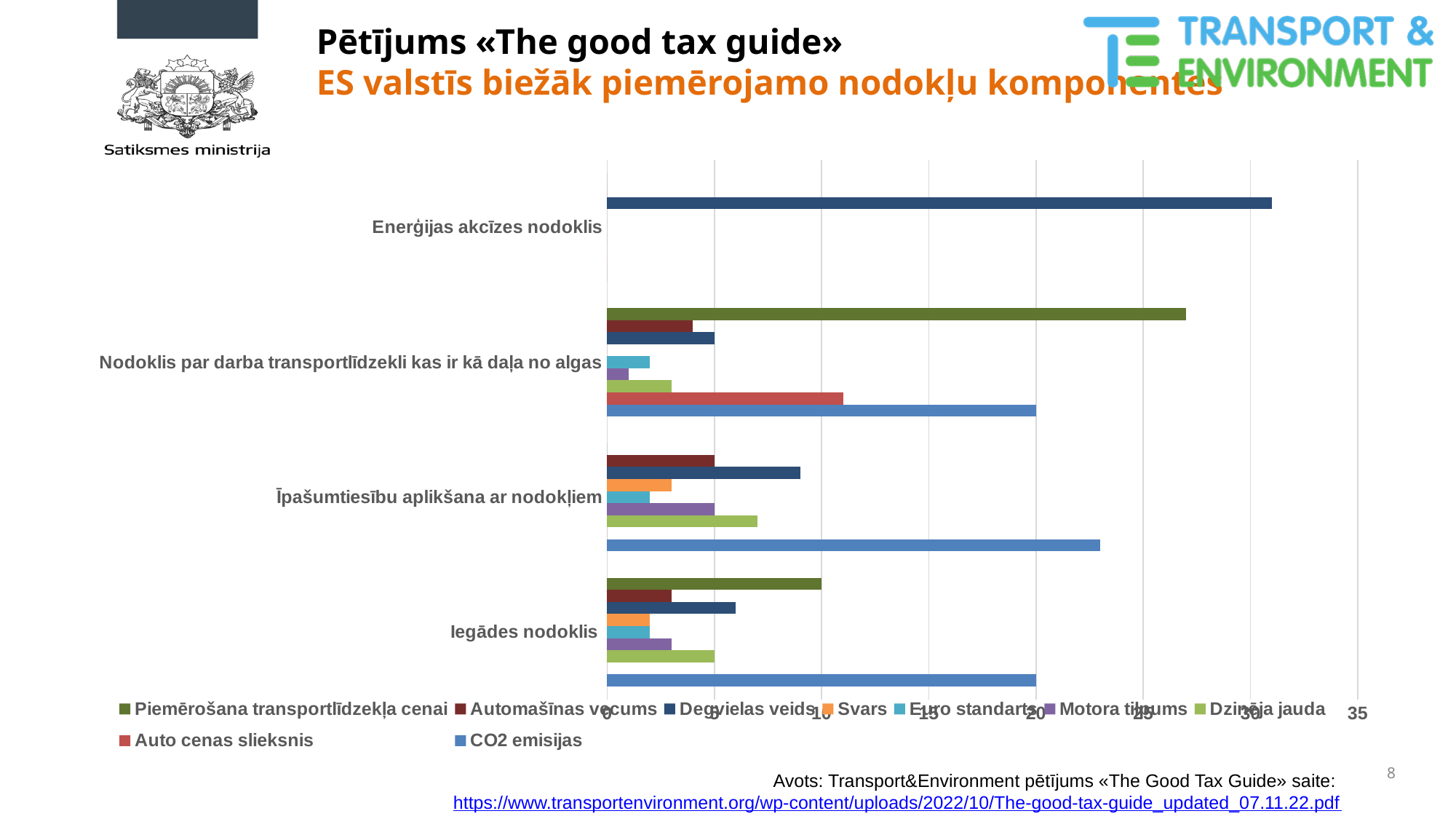
For Iegādes nodoklis, which series has the longest bar? CO2 emisijas What kind of chart is shown on the slide? bar chart How many series does the chart legend list? 9 For Nodoklis par darba transportlīdzekli kas ir kā daļa no algas, which is larger: Auto cenas slieksnis or Dzinēja jauda? Auto cenas slieksnis Which is the only series with a bar shown for Enerģijas akcīzes nodoklis? Degvielas veids For Īpašumtiesību aplikšana ar nodokļiem, which is larger: Degvielas veids or Svars? Degvielas veids How many tax categories are listed on the vertical axis of the chart? 4 Is the value of Piemērošana transportlīdzekļa cenai for Nodoklis par darba transportlīdzekli kas ir kā daļa no algas greater or less than 25? greater Is the value of CO2 emisijas for Īpašumtiesību aplikšana ar nodokļiem greater or less than 20? greater Is the value of Degvielas veids for Enerģijas akcīzes nodoklis greater or less than 30? greater Which category has the longest Degvielas veids bar? Enerģijas akcīzes nodoklis